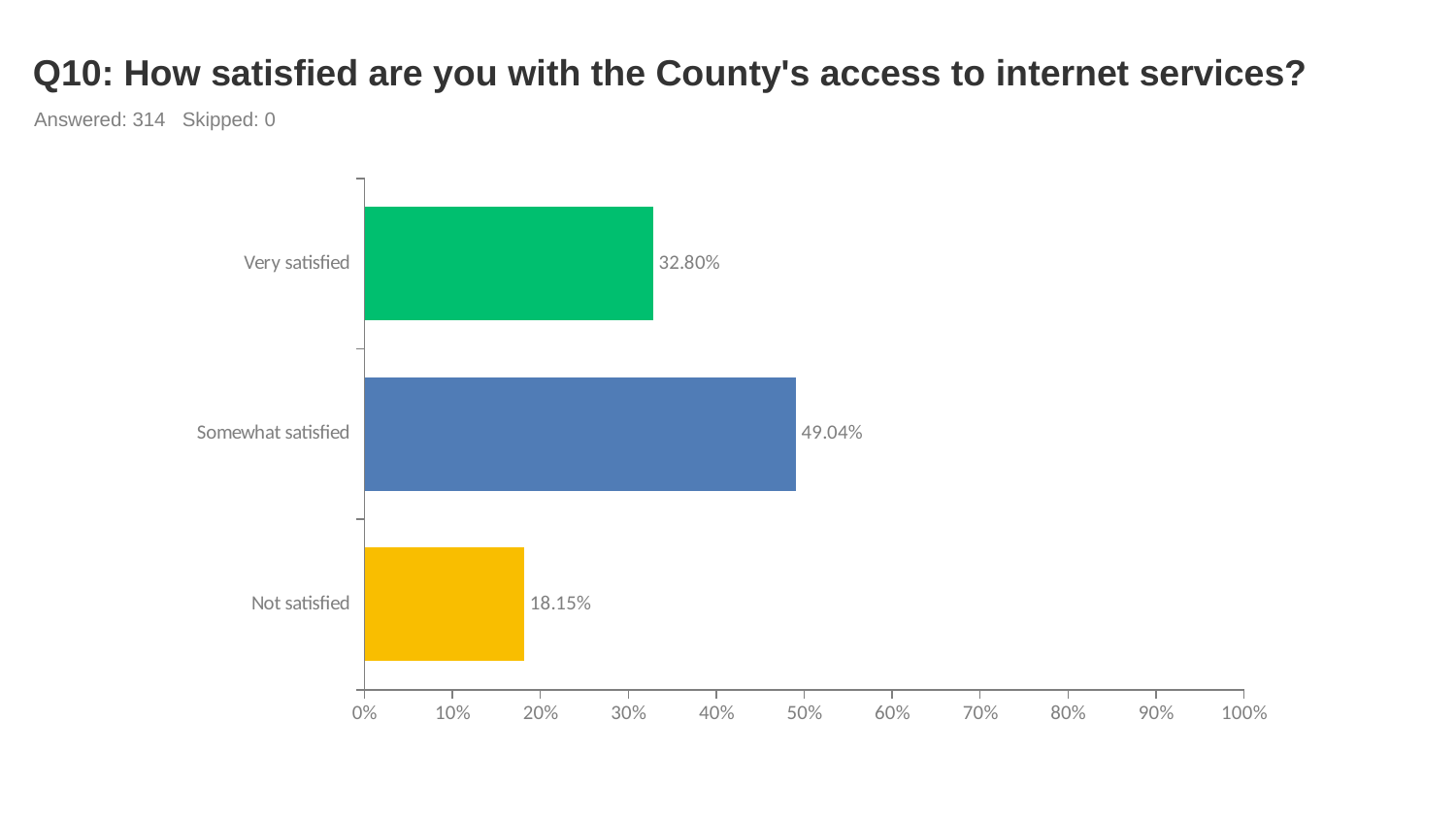
What is the difference in percentage points between Very satisfied and Not satisfied? 14.65 What type of chart is shown on the slide? Bar chart What percentage of respondents were very satisfied with the County's access to internet services? 32.80% How many response categories are shown in the chart? 3 How many respondents answered this question? 314 Which is larger, the percentage for Very satisfied or for Not satisfied? Very satisfied Is the value for Somewhat satisfied greater or less than 40%? greater Which response category has the highest percentage? Somewhat satisfied What percentage of respondents were somewhat satisfied? 49.04% Which response category has the lowest percentage? Not satisfied What is the difference in percentage points between Somewhat satisfied and Very satisfied? 16.24 What percentage of respondents were not satisfied? 18.15%